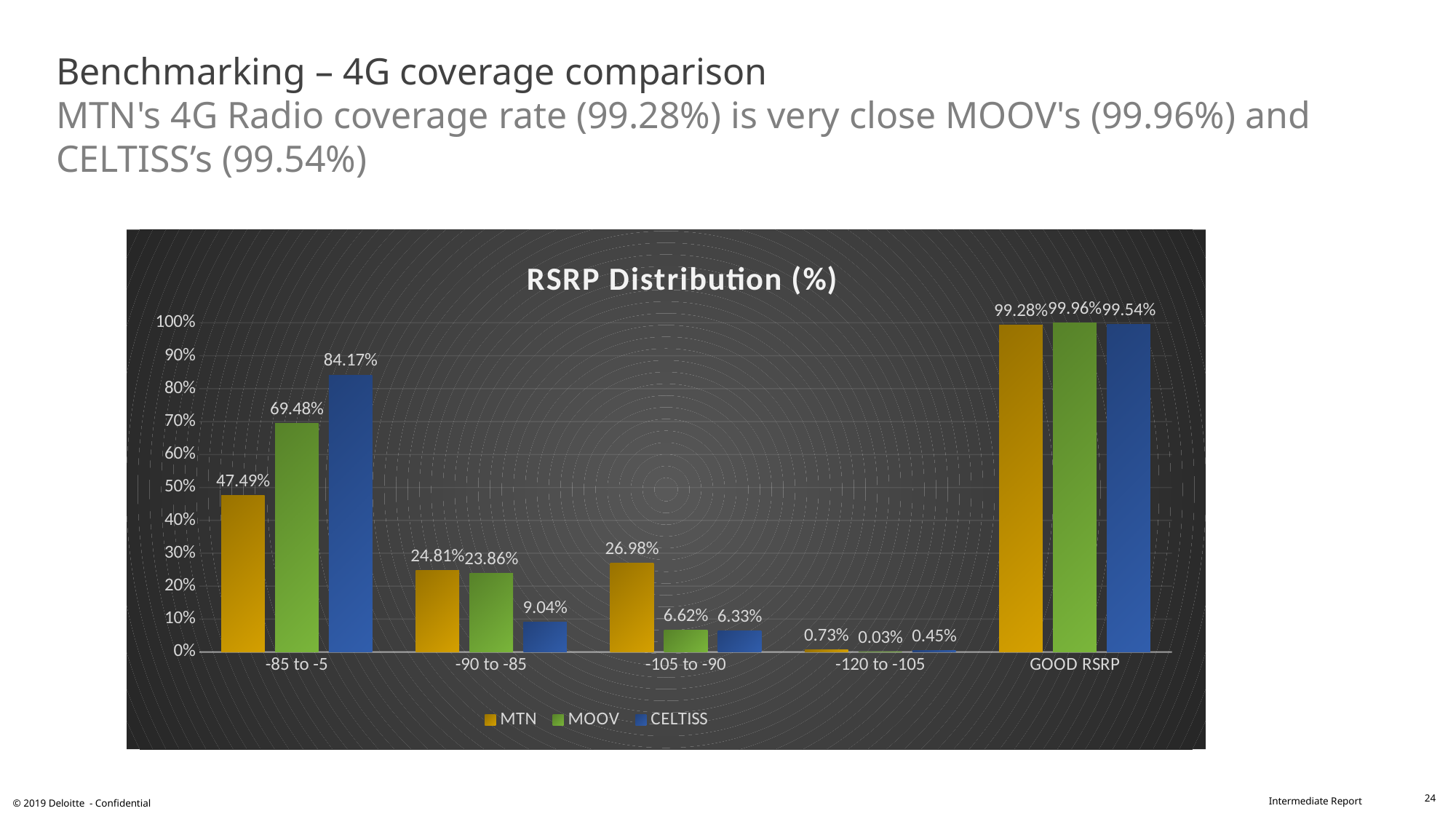
What is the MTN value for the -105 to -90 category? 26.98% How many series does the legend list? 3 How many categories are shown on the x axis? 5 Which is larger in the -105 to -90 category, the MOOV value or the CELTISS value? MOOV Which operator has the lowest value in the GOOD RSRP category? MTN What type of chart is shown on the slide? Bar chart What is the MOOV value for the -120 to -105 category? 0.03% What is the MTN value for the -85 to -5 category? 47.49% What is the difference between the CELTISS and MTN values in the -85 to -5 category? 36.68% Which operator has the highest value in the -85 to -5 category? CELTISS What is the CELTISS value for the -85 to -5 category? 84.17% What is the MOOV value for the -90 to -85 category? 23.86%